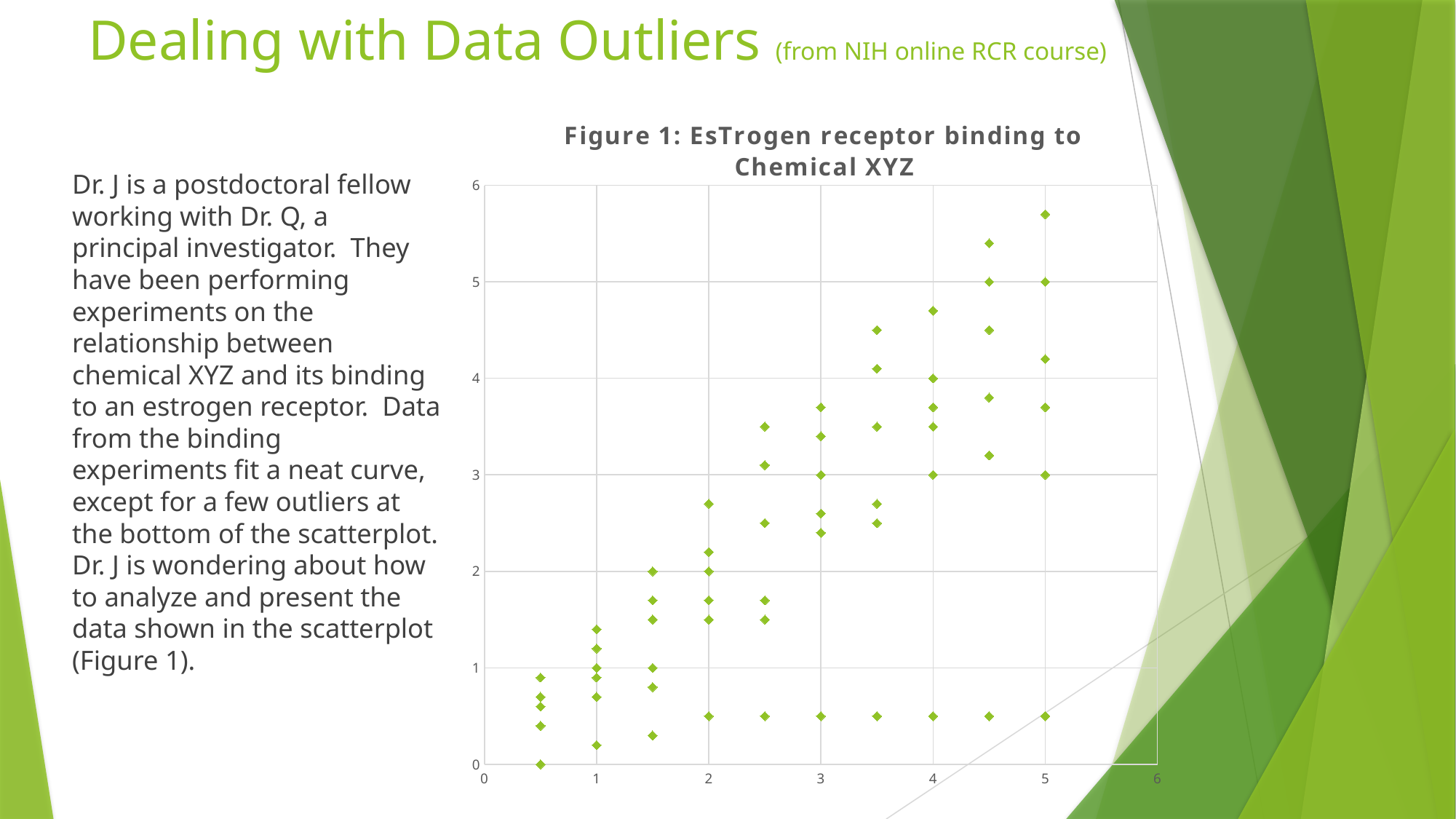
How many distinct x positions have data points plotted? 10 At which x value does the highest point in the scatter plot occur? 5 Is the highest point at x = 3 greater or less than 4? less Is the highest point at x = 4.5 greater or less than 5? greater Is the highest point at x = 1 greater or less than 2? less What kind of chart is shown on the slide? scatter plot At which x value does the lowest point in the scatter plot occur? 0.5 Overall, do the upper points in the scatter plot rise or fall as the x value increases? rise What is the highest value shown on the vertical axis of the chart? 6 What is the title of the chart? Figure 1: EsTrogen receptor binding to Chemical XYZ